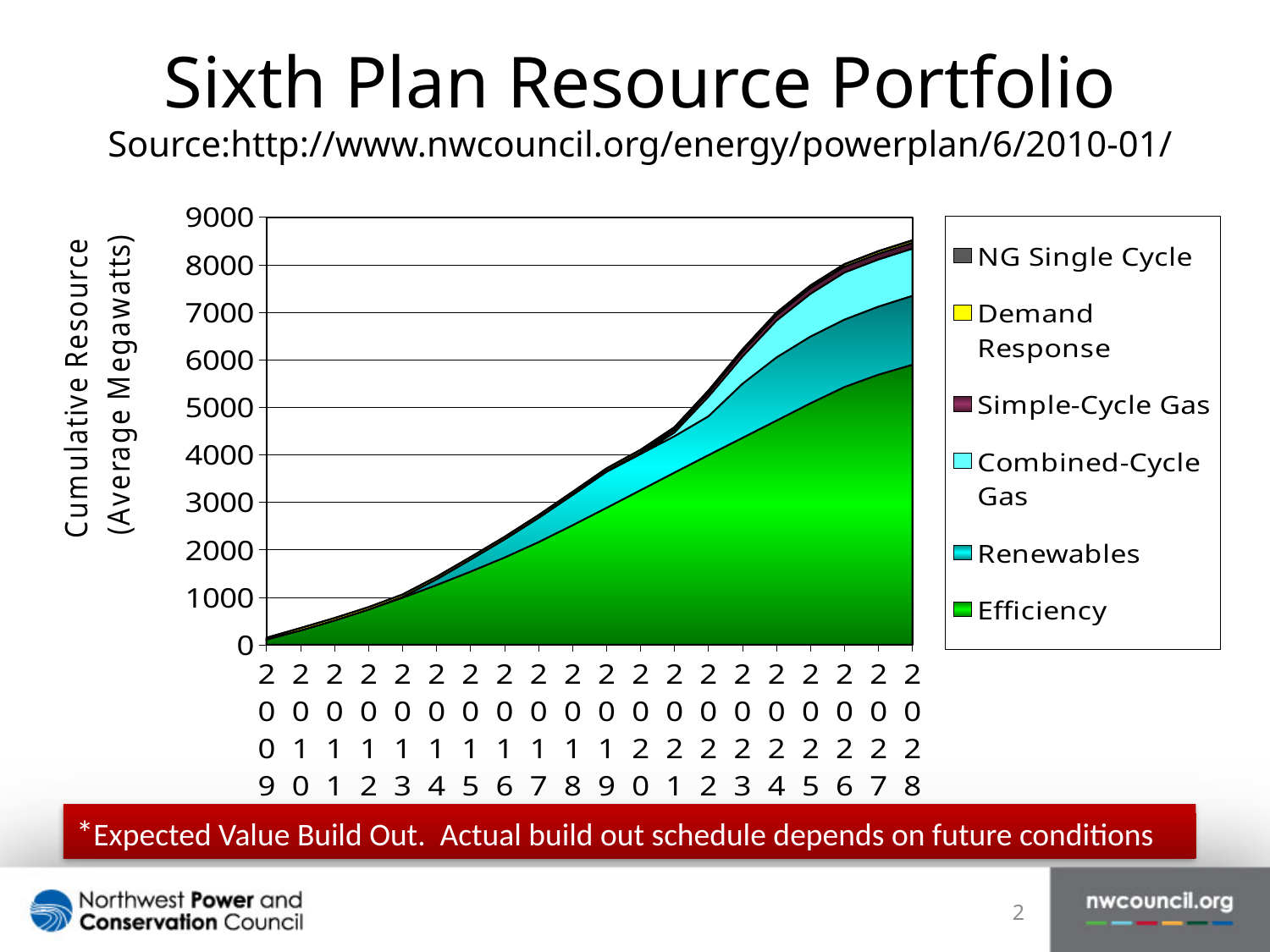
What is the first year shown on the x axis? 2009 Is the Efficiency value in 2028 greater or less than 5000? greater What is the label of the y axis? Cumulative Resource (Average Megawatts) How many years are shown along the x axis? 20 Is the total cumulative resource in 2009 greater or less than 1000? less Does the total cumulative resource rise or fall from 2009 to 2028? Rise Is the total cumulative resource in 2028 greater or less than 8000? greater How many series does the legend list? 6 Which series contributes the largest share of the cumulative resource in 2028? Efficiency What kind of chart is shown on the slide? Stacked area chart